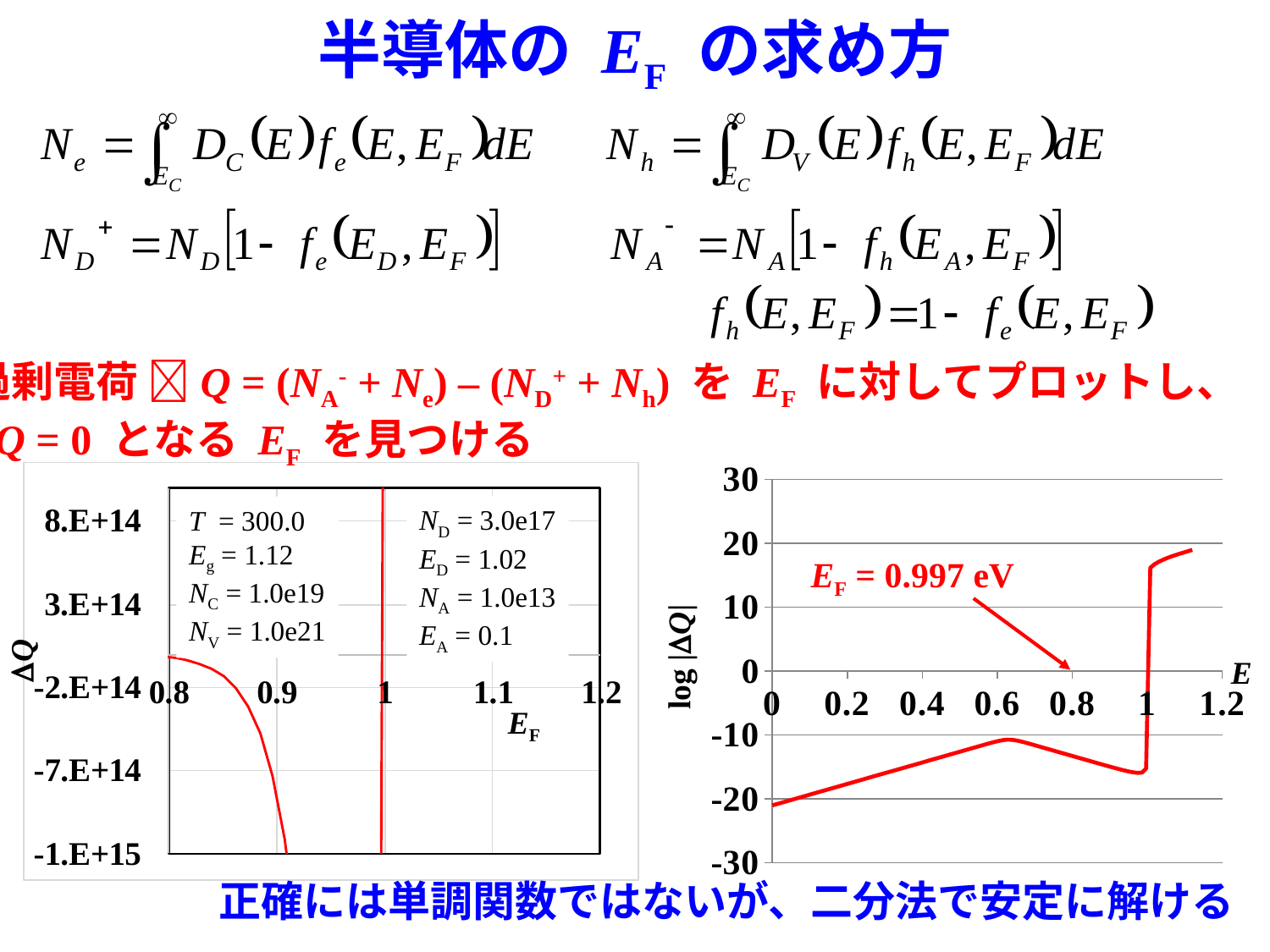
On the left chart, is the value of ΔQ at E_F = 0.8 greater or less than -7.E+14? greater On the left chart, what is the label of the y axis? ΔQ On the right chart, is the value of log|ΔQ| at E = 0.6 greater or less than -20? greater On the left chart, does ΔQ rise or fall as E_F goes from 0.8 to 0.9? fall On the right chart, does log|ΔQ| rise or fall as E goes from 0 to 0.6? rise On the right chart, what value of E_F is indicated by the annotation? 0.997 eV On the right chart, how many tick labels are shown on the x axis? 7 On the right chart, does log|ΔQ| rise or fall as E goes from 0.6 to 0.95? fall What kind of chart is the right chart (log|ΔQ| versus E)? line chart What kind of chart is the left chart (ΔQ versus E_F)? line chart On the right chart, is the value of log|ΔQ| at E = 0.6 greater or less than 0? less